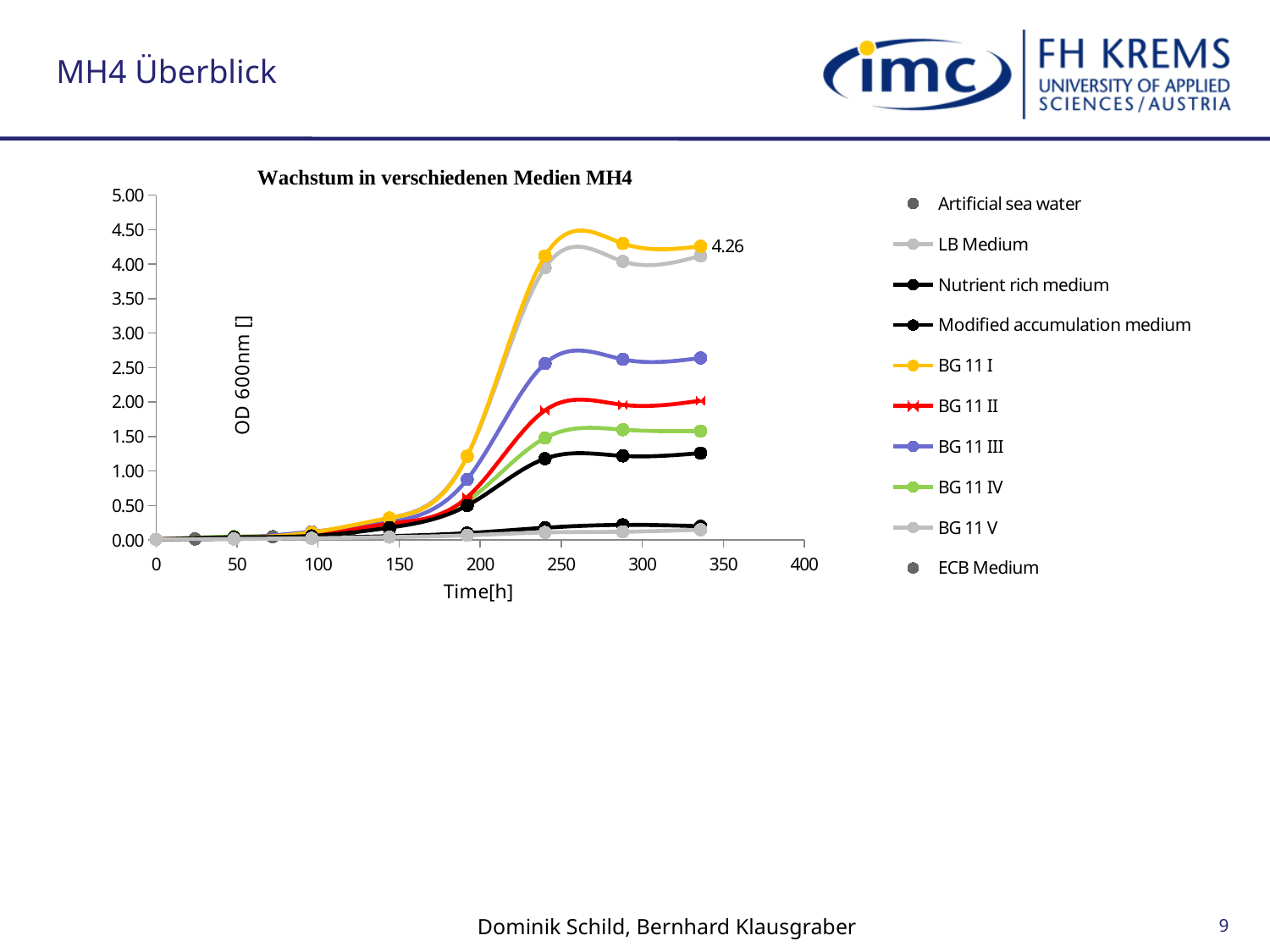
What value is labelled at the end of the BG 11 I series? 4.26 Which series reaches the highest OD 600nm value in the chart? BG 11 I What is the label of the x axis of the chart? Time[h] What is the title of the chart? Wachstum in verschiedenen Medien MH4 Is the final OD 600nm value for BG 11 IV greater or less than 1.00? greater At the final time point, which series has the larger OD 600nm value, BG 11 III or BG 11 IV? BG 11 III Is the final OD 600nm value for BG 11 I greater or less than 4.00? greater Is the final OD 600nm value for BG 11 III greater or less than 2.00? greater How many series does the chart legend list? 10 Does the OD 600nm value for BG 11 I rise or fall as time increases? rise What type of chart is shown on the slide? line chart